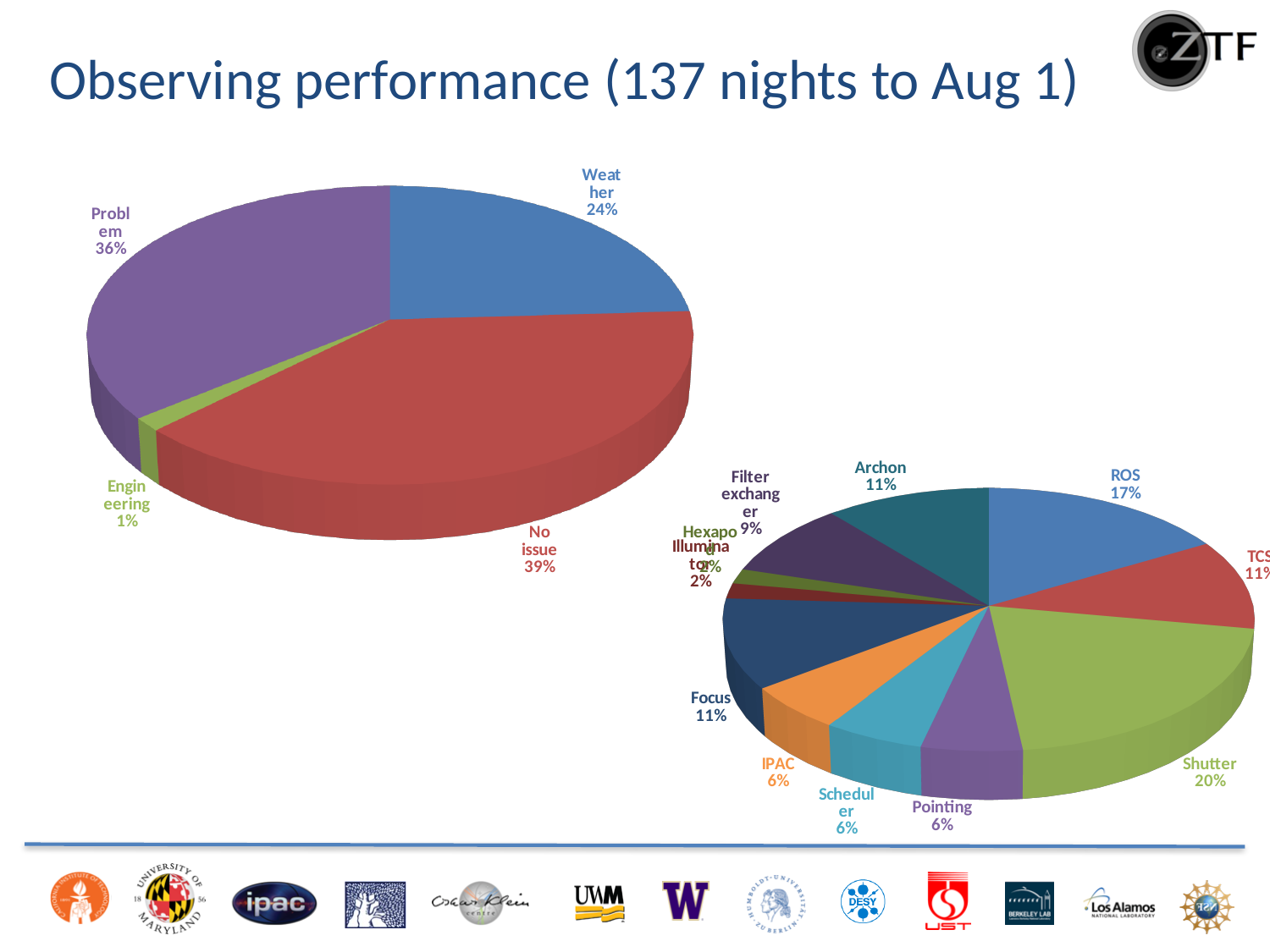
What is the title of the slide containing the two pie charts? Observing performance (137 nights to Aug 1) In the left pie chart, which category has the largest share? No issue In the right pie chart, which is larger, Focus or IPAC? Focus In the left pie chart, what share of nights had no issue? 39% How many slices does the left pie chart have? 4 In the left pie chart, what is the difference between the Problem share and the Weather share? 12% In the right pie chart, what share is labelled Filter exchanger? 9% What type of chart is the chart on the right of the slide? Pie chart In the left pie chart, which category has the smallest share? Engineering In the right pie chart, what share is labelled ROS? 17% In the left pie chart, what percentage is labelled Weather? 24% In the right pie chart, what share is labelled Shutter? 20%